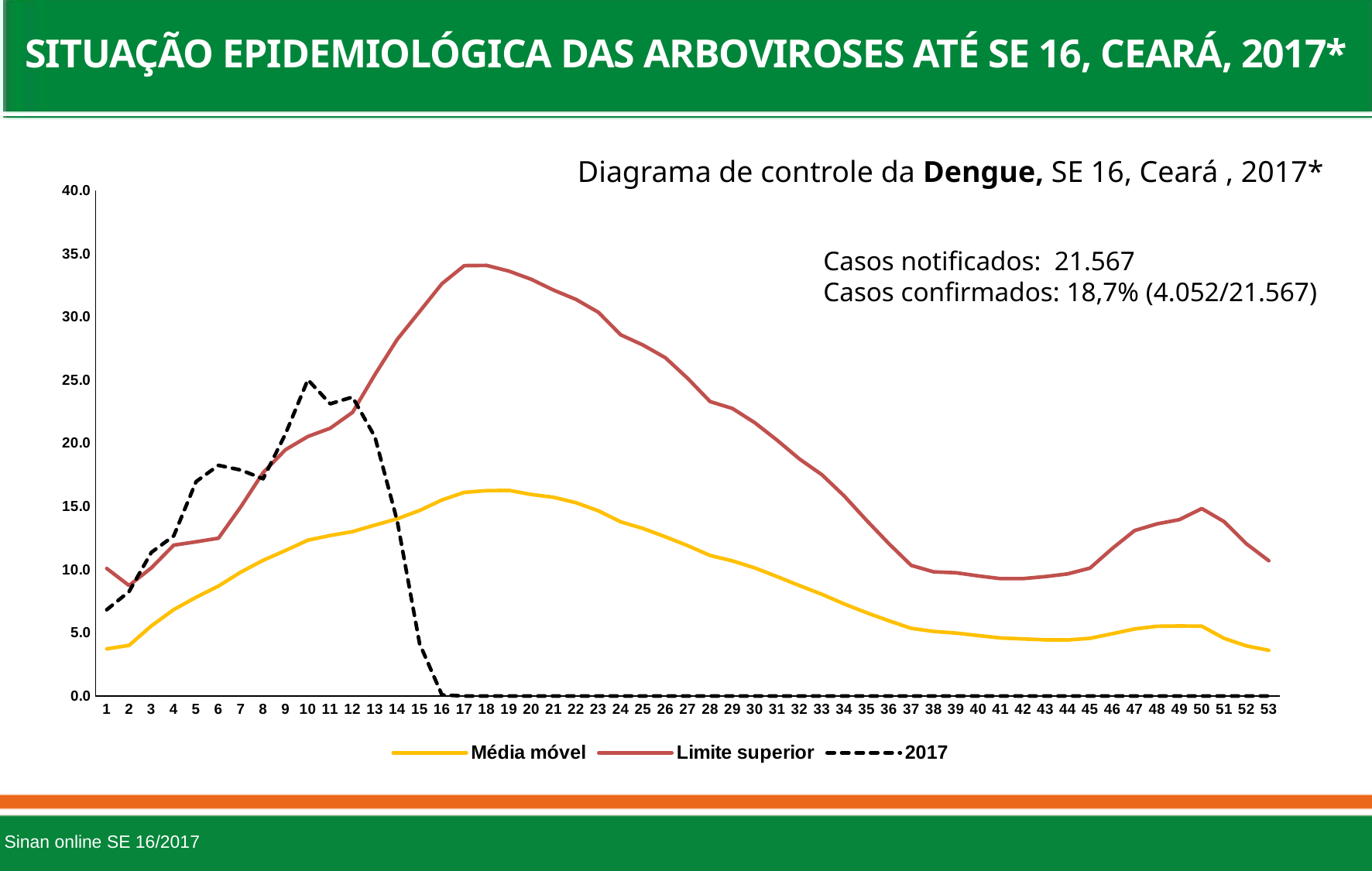
Is the value of the 2017 series at week 10 greater or less than 20.0? greater Is the value of Limite superior at week 28 greater or less than 20.0? greater Which series reaches the highest value on the chart? Limite superior Which series is drawn as a dashed line? 2017 What kind of chart is shown on the slide? line chart Does the 2017 series rise or fall between week 10 and week 16? fall Is the value of Limite superior at week 17 greater or less than 30.0? greater How many series does the legend list? 3 How many epidemiological weeks are shown along the x axis? 53 At week 30, which is larger: Limite superior or Média móvel? Limite superior At week 10, which is larger: the 2017 series or Limite superior? 2017